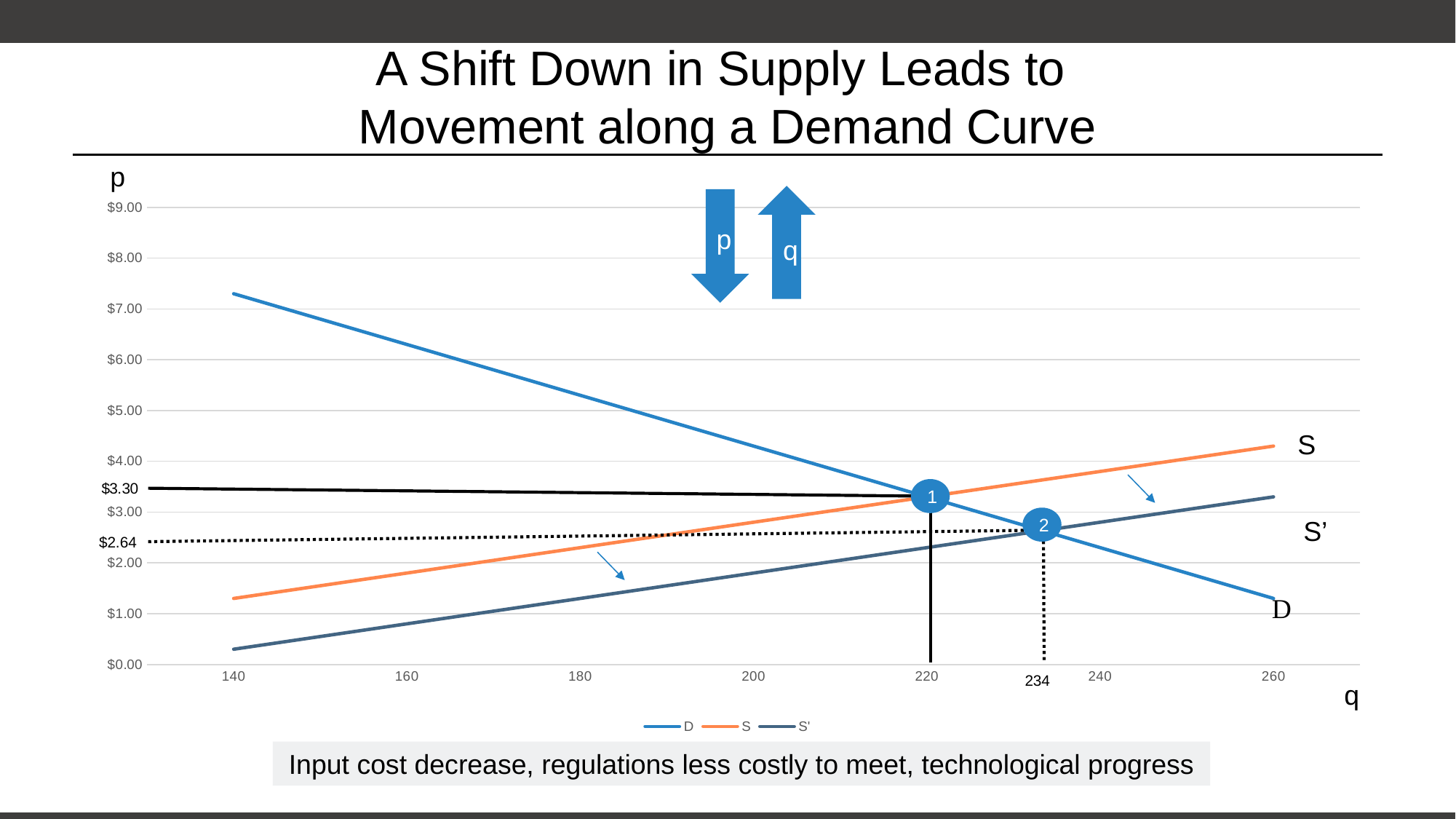
What is the quantity at equilibrium point 1? 220 By how much does the quantity increase from equilibrium point 1 to equilibrium point 2? 14 How many series does the chart legend list? 3 What are the series names listed in the chart legend? D, S, S' Does the D line rise or fall as q increases? fall What is the price at equilibrium point 2? $2.64 By how much does the price fall from equilibrium point 1 to equilibrium point 2? $0.66 What kind of chart is shown on the slide? line chart Is the value of the D line at q = 140 greater or less than $7.00? greater Which equilibrium point has the higher price, point 1 or point 2? point 1 What is the quantity at equilibrium point 2? 234 What is the price at equilibrium point 1? $3.30